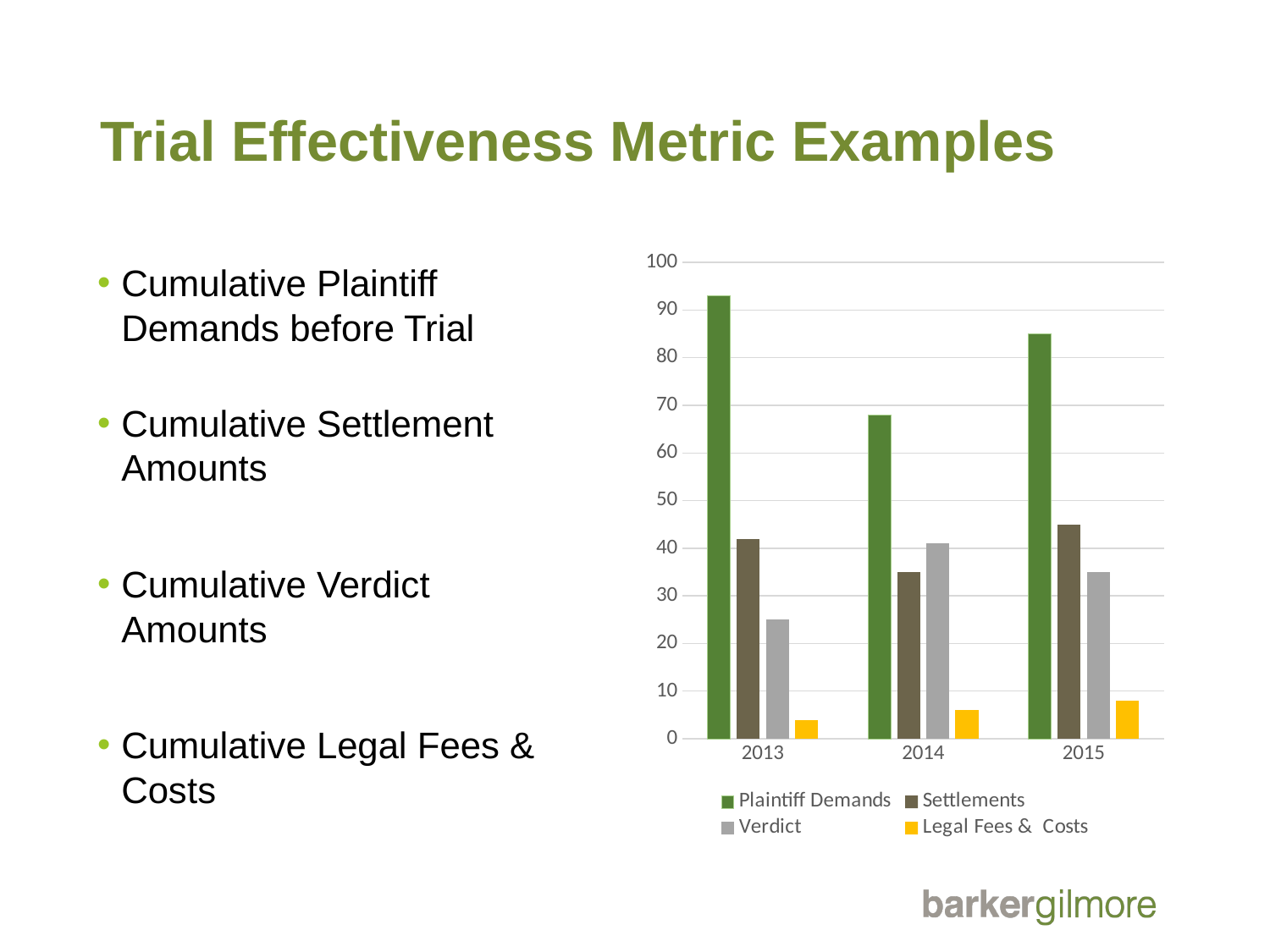
Do the Legal Fees & Costs values rise or fall from 2013 to 2015? rise How many series does the chart legend list? 4 In which year is the Legal Fees & Costs bar lowest? 2013 Is the value for Plaintiff Demands in 2013 greater or less than 80? greater Is the value for Plaintiff Demands in 2014 greater or less than 60? greater Which series is shown in yellow in the chart? Legal Fees & Costs How many years are shown on the x axis of the chart? 3 In 2014, which is larger: Settlements or Verdict? Verdict Is the value for Verdict in 2013 greater or less than 30? less In which year is the Plaintiff Demands bar highest? 2013 What kind of chart is shown on the slide? bar chart